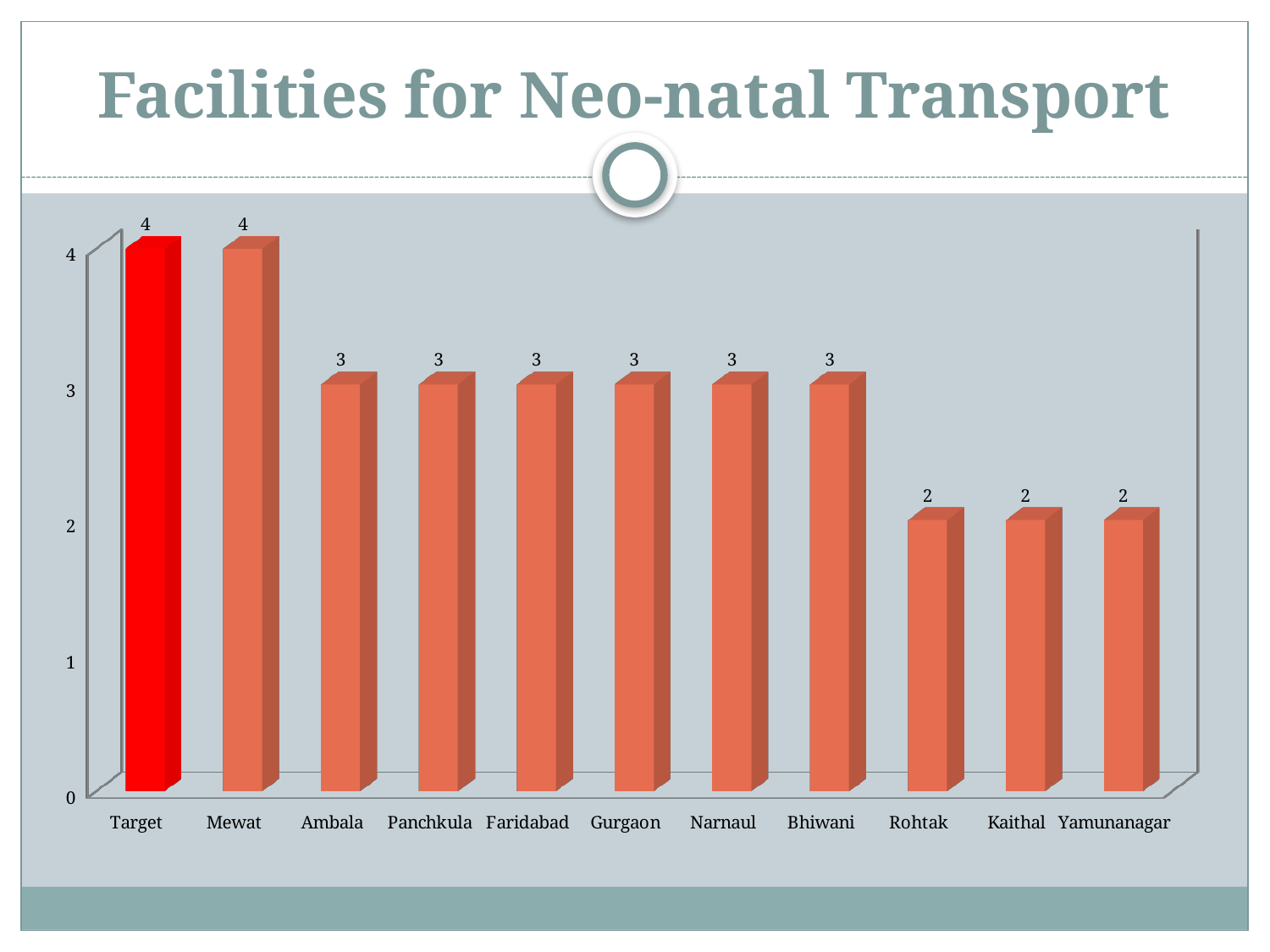
What is the value for Mewat? 4 What is the difference between the Target value and the value for Ambala? 1 Do the values generally rise or fall from left to right along the x axis? fall What is the value for Gurgaon? 3 Which bar is coloured differently (bright red) from the others? Target What is the value for Rohtak? 2 Which is larger, the value for Bhiwani or the value for Yamunanagar? Bhiwani What kind of chart is shown on the slide? bar chart What is the difference between the values for Mewat and Kaithal? 2 What is the title of the slide? Facilities for Neo-natal Transport How many categories are shown on the x axis? 11 What is the value for the Target bar? 4